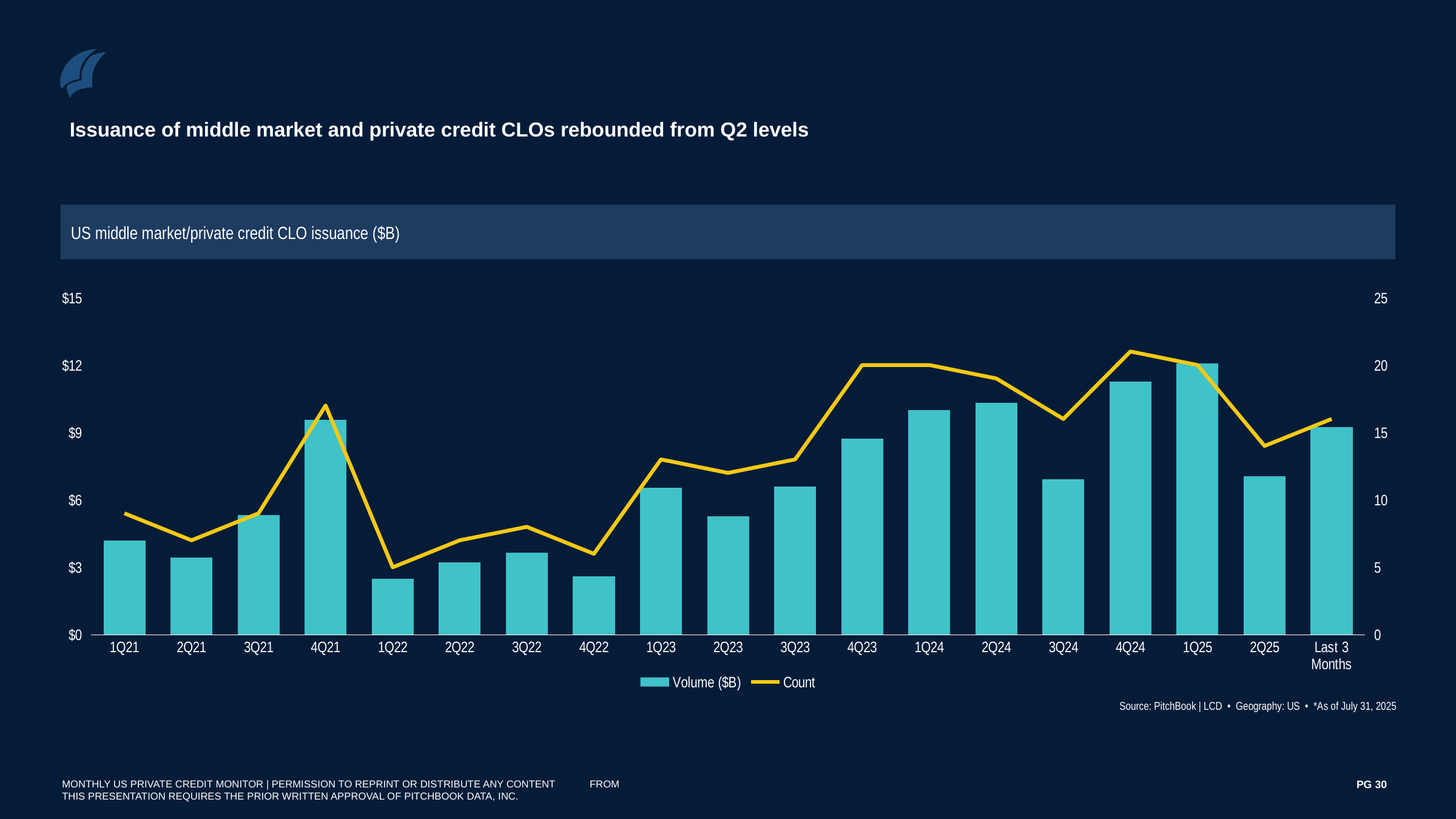
Which period has the highest Count value? 4Q24 Does the Volume ($B) rise or fall from 1Q25 to 2Q25? fall Is the Count for 4Q23 greater or less than 15? greater Which period has the highest Volume ($B) bar? 1Q25 How many series does the legend list? 2 Which period has the lowest Count value? 1Q22 Is the Volume ($B) for 1Q22 greater or less than $3? less Which has the larger Volume ($B), 4Q24 or 1Q25? 1Q25 What colour are the Volume ($B) bars? Teal What kind of chart is shown on the slide? A bar and line chart Is the Volume ($B) for 4Q24 greater or less than $9? greater How many categories are shown on the x axis? 19